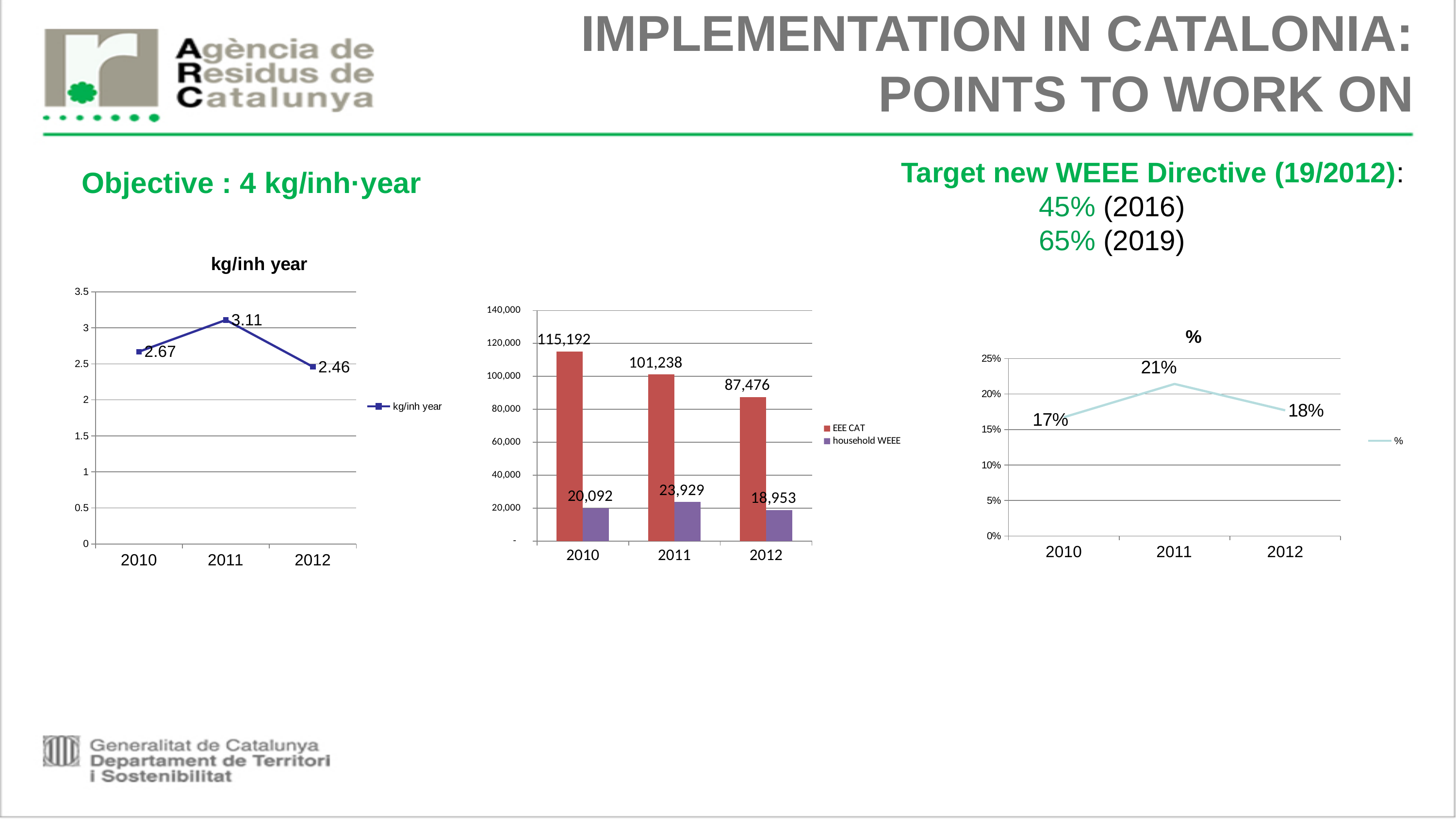
In the middle bar chart, what is the EEE CAT value for 2010? 115,192 In the 'kg/inh year' line chart on the left, what is the value for 2011? 3.11 In the '%' line chart on the right, which is larger, the value for 2010 or the value for 2012? 2012 In the 'kg/inh year' line chart on the left, what is the difference between the 2011 and 2010 values? 0.44 In the '%' line chart on the right, what is the value for 2011? 21% In the 'kg/inh year' line chart on the left, which year has the lowest value? 2012 In the middle bar chart, what is the household WEEE value for 2012? 18,953 How many years are plotted on the x axis of the '%' line chart on the right? 3 In the middle bar chart, do the EEE CAT values rise or fall from 2010 to 2012? Fall In the middle bar chart, which year has the highest household WEEE value? 2011 What kind of chart is the middle chart on the slide? Bar chart In the middle bar chart, how many series does the legend list? 2